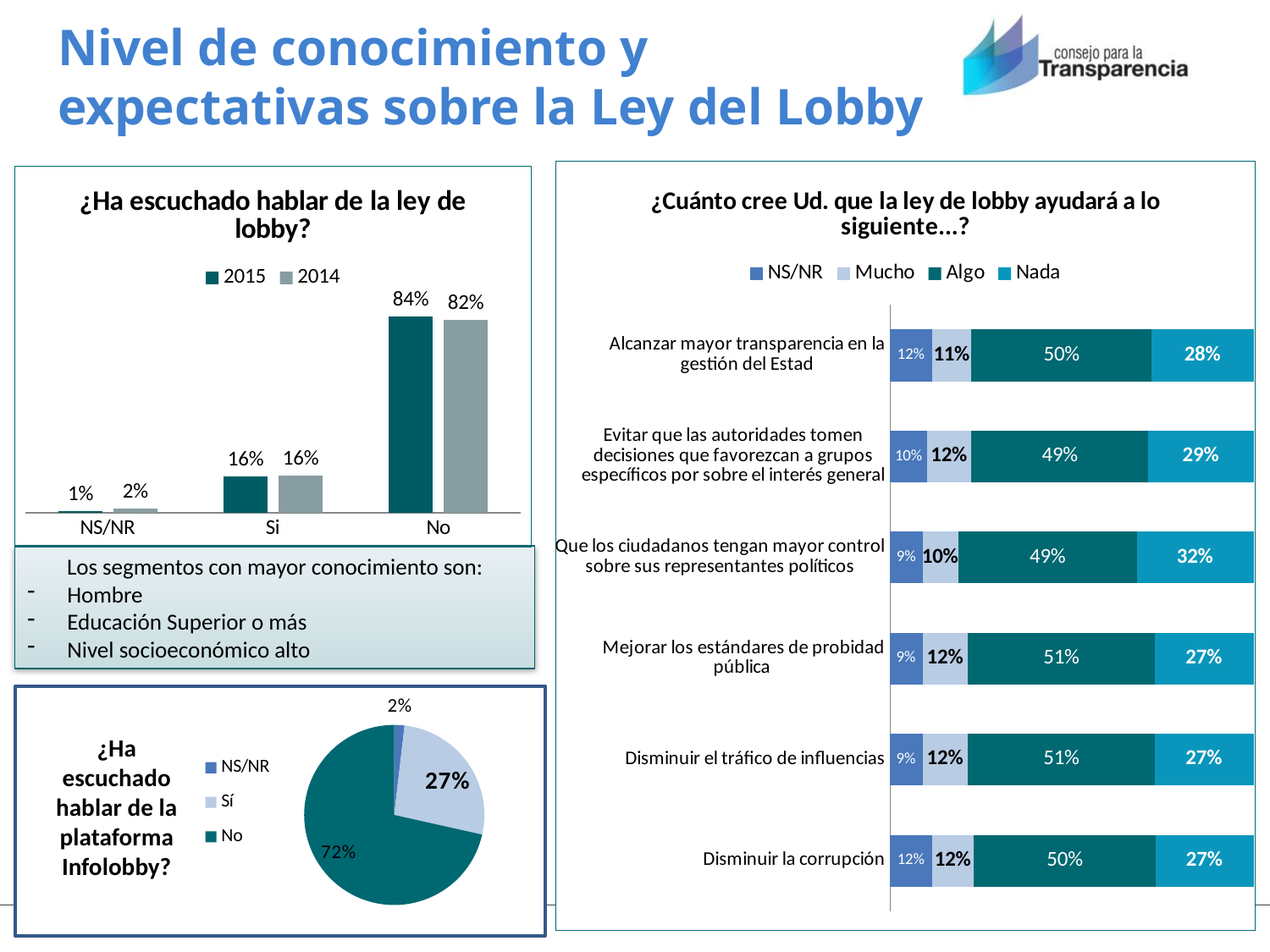
In the chart '¿Ha escuchado hablar de la ley de lobby?', what is the value for 'No' in 2015? 84% In the pie chart '¿Ha escuchado hablar de la plataforma Infolobby?', what share does 'Sí' have? 27% In the chart '¿Ha escuchado hablar de la ley de lobby?', what is the value for 'Si' in 2014? 16% In the chart '¿Cuánto cree Ud. que la ley de lobby ayudará a lo siguiente...?', how many categories are shown? 6 In the chart '¿Ha escuchado hablar de la ley de lobby?', how many series does the legend list? 2 In the chart '¿Cuánto cree Ud. que la ley de lobby ayudará a lo siguiente...?', what is the 'Nada' value for 'Que los ciudadanos tengan mayor control sobre sus representantes políticos'? 32% In the chart '¿Ha escuchado hablar de la ley de lobby?', which category has the lowest value in 2015? NS/NR In the chart '¿Ha escuchado hablar de la ley de lobby?', what is the difference between the 2015 and 2014 values for 'No'? 2% In the pie chart '¿Ha escuchado hablar de la plataforma Infolobby?', which slice is the largest? No What kind of chart is '¿Ha escuchado hablar de la plataforma Infolobby?'? pie chart In the chart '¿Cuánto cree Ud. que la ley de lobby ayudará a lo siguiente...?', what is the 'Algo' value for 'Mejorar los estándares de probidad pública'? 51% In the chart '¿Cuánto cree Ud. que la ley de lobby ayudará a lo siguiente...?', which is larger: the 'Nada' value for 'Evitar que las autoridades tomen decisiones que favorezcan a grupos específicos por sobre el interés general' or the 'Nada' value for 'Disminuir la corrupción'? Evitar que las autoridades tomen decisiones que favorezcan a grupos específicos por sobre el interés general